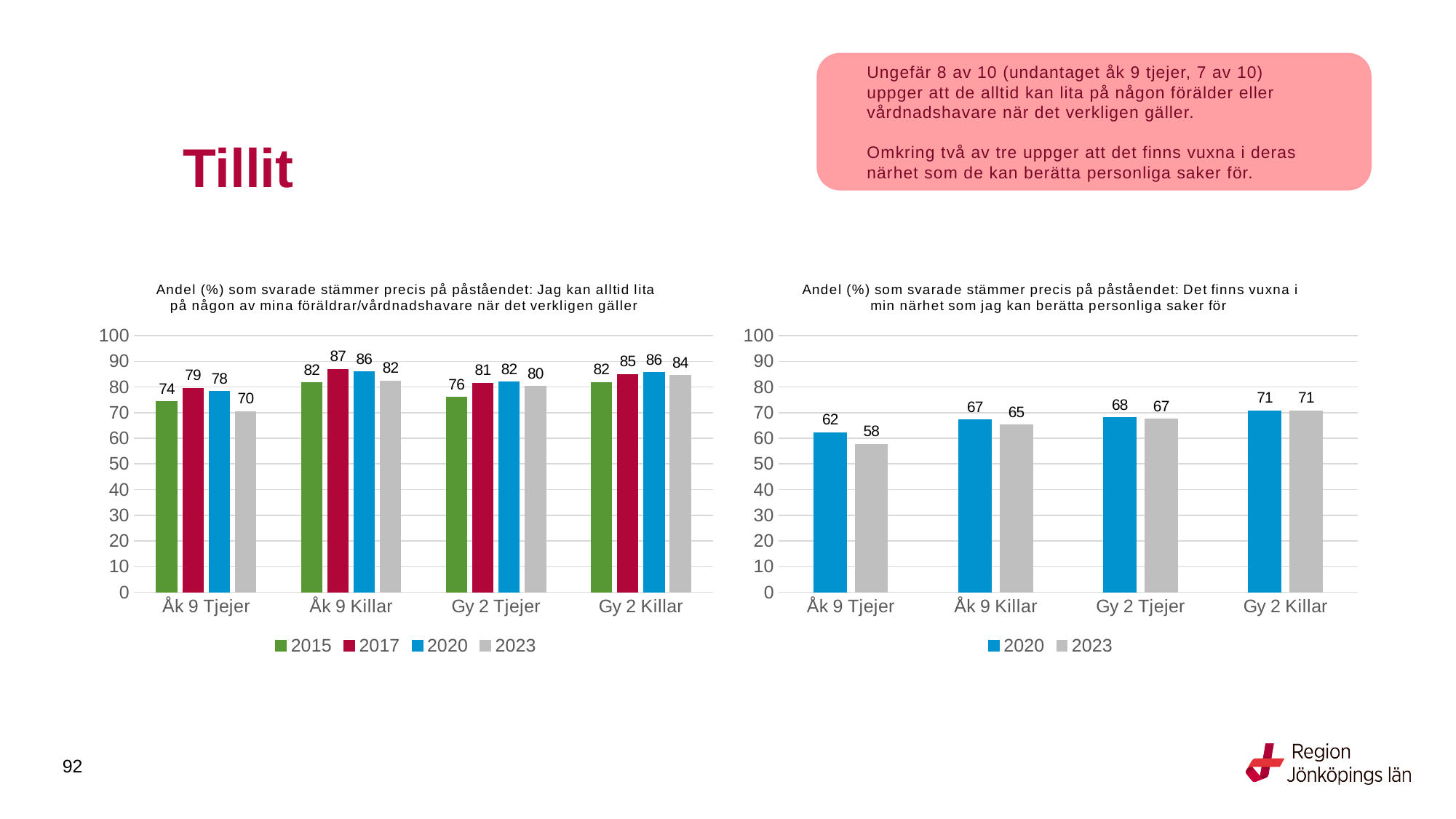
In the left chart, do the values for Åk 9 Tjejer rise or fall from 2020 to 2023? Fall In the right chart, what is the difference between the 2020 and 2023 values for Åk 9 Tjejer? 4 In the left chart, which category has the highest value for 2020? Åk 9 Killar and Gy 2 Killar (tied at 86) In the right chart, what is the value for Åk 9 Tjejer in 2020? 62 How many categories are shown on the x axis of the right chart? 4 How many series does the legend of the left chart list? 4 What kind of chart is the right chart? Bar chart In the left chart, what is the difference between the 2017 and 2015 values for Gy 2 Tjejer? 5 In the right chart, which category has the lowest value for 2023? Åk 9 Tjejer In the left chart, what is the value for Åk 9 Tjejer in 2023? 70 In the left chart, which is larger for Gy 2 Killar: the 2015 value or the 2023 value? 2023 In the left chart, what is the value for Åk 9 Killar in 2017? 87